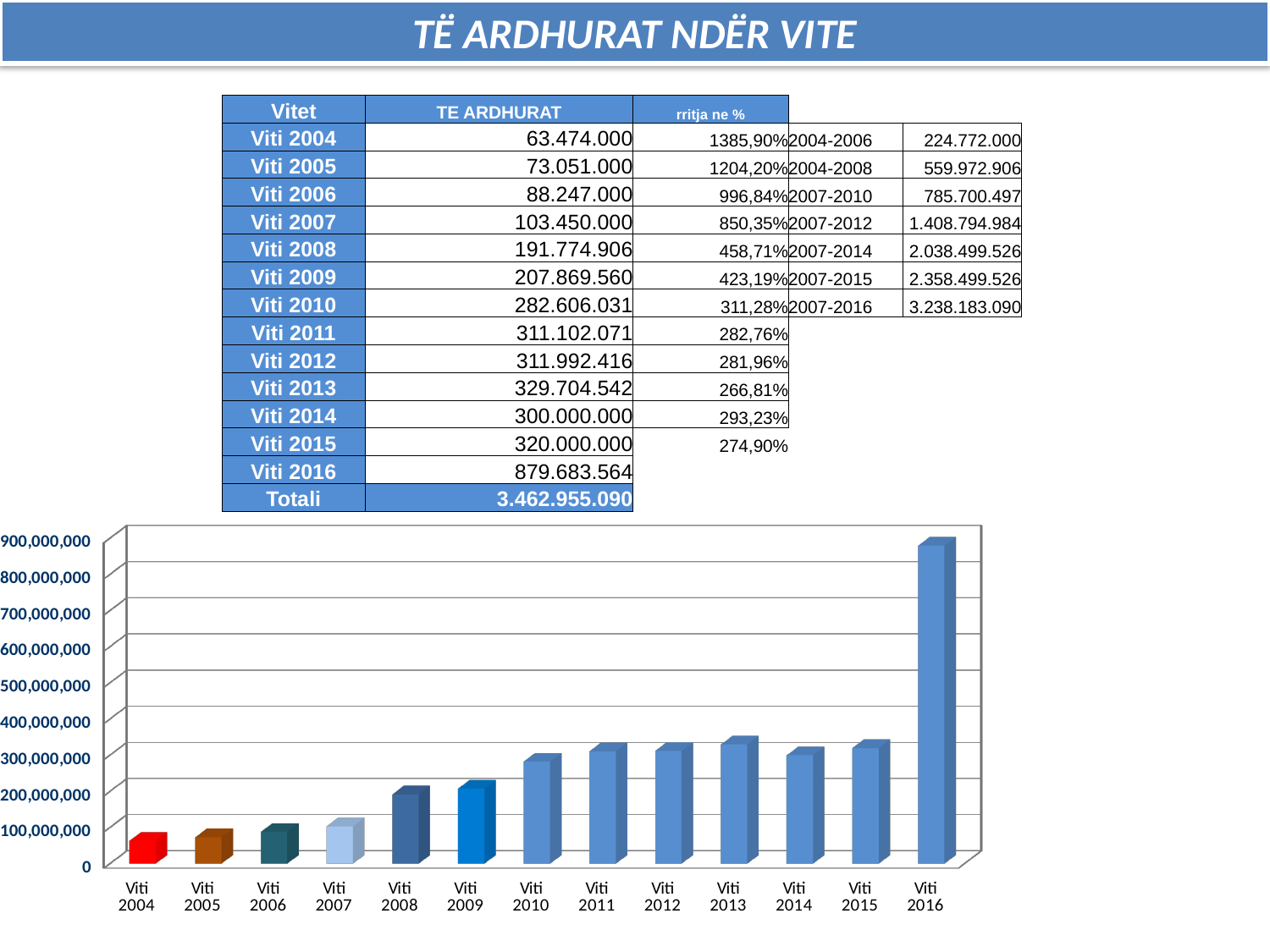
Is the value for Viti 2004 greater or less than 100,000,000? less Is the value for Viti 2013 greater or less than 300,000,000? greater What kind of chart is shown on the slide? bar chart How many bars (years) does the chart show? 13 According to the table above the chart, what is the value (TE ARDHURAT) for Viti 2014? 300.000.000 According to the table above the chart, what is the value (TE ARDHURAT) for Viti 2016? 879.683.564 Which year has the lowest bar in the chart? Viti 2004 Which is larger, the value for Viti 2016 or the value for Viti 2015? Viti 2016 What colour is the bar for Viti 2004? red Which year has the highest bar in the chart? Viti 2016 Using the values in the table, what is the difference between Viti 2016 and Viti 2015? 559.683.564 Is the value for Viti 2016 greater or less than 800,000,000? greater